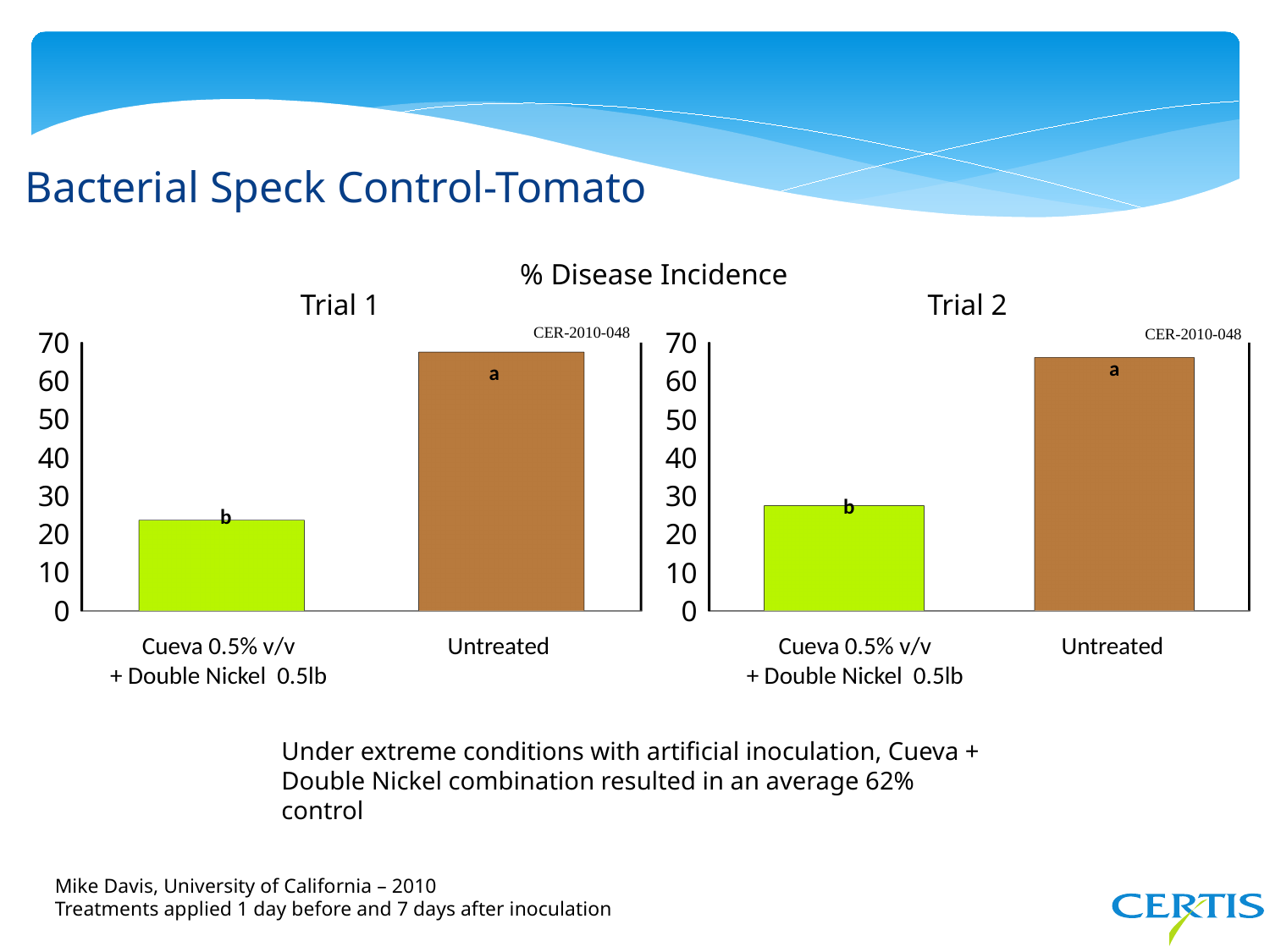
In the Trial 1 chart, what letter is printed on the Untreated bar? a In the Trial 2 chart, is the value for Untreated greater or less than 70? less In the Trial 1 chart, which treatment has the highest % disease incidence? Untreated In the Trial 2 chart, is the value for Cueva 0.5% v/v + Double Nickel 0.5lb greater or less than 20? greater What quantity do the two charts plot, according to the shared title above them? % Disease Incidence In the Trial 2 chart, which is larger: the value for Untreated or the value for Cueva 0.5% v/v + Double Nickel 0.5lb? Untreated What kind of chart is the Trial 1 chart? bar chart In the Trial 1 chart, is the value for Cueva 0.5% v/v + Double Nickel 0.5lb greater or less than 30? less In the Trial 2 chart, which treatment has the lowest % disease incidence? Cueva 0.5% v/v + Double Nickel 0.5lb What is the highest value shown on the y axis of the Trial 1 chart? 70 How many bars are shown in the Trial 2 chart? 2